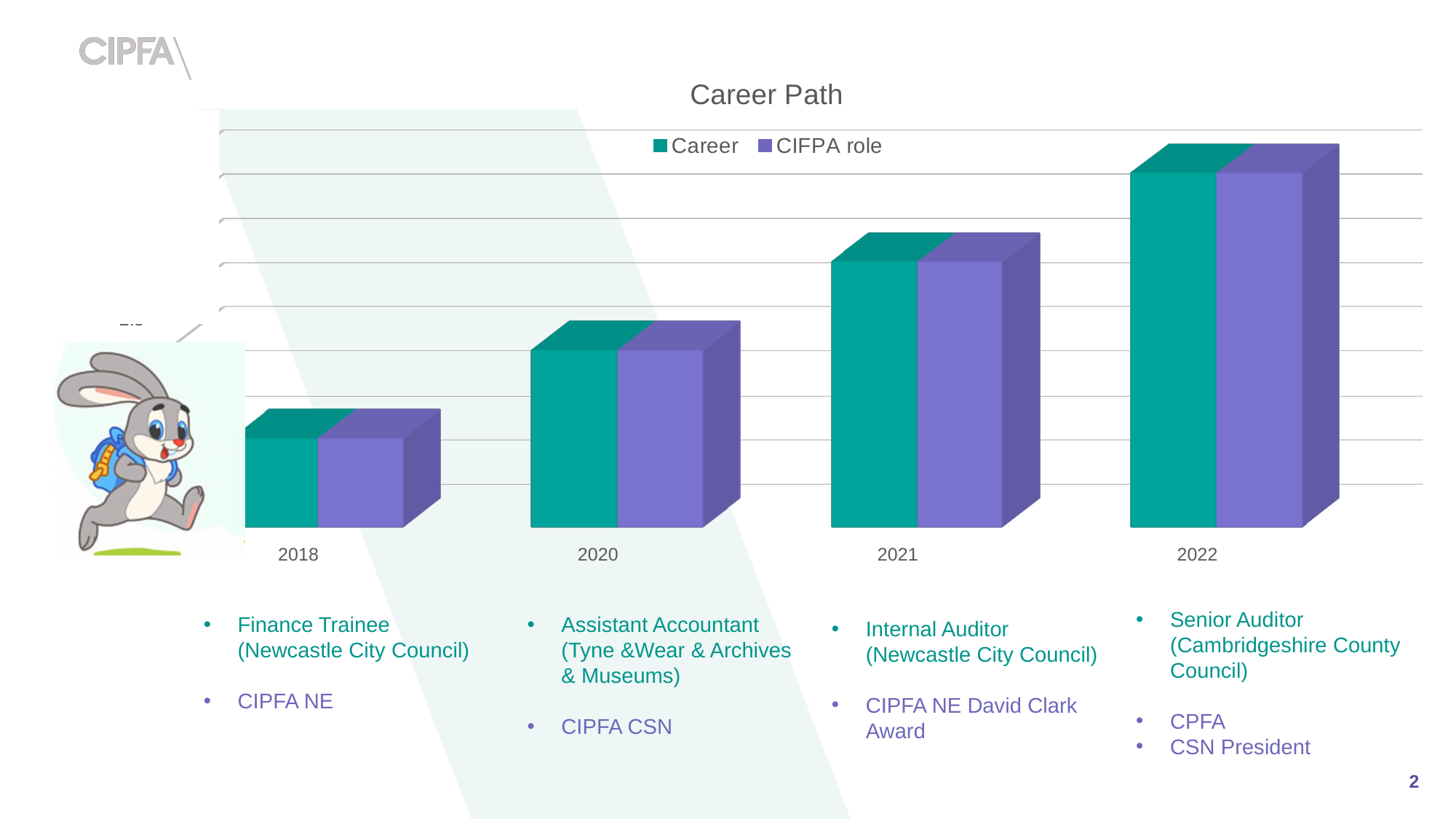
Which year comes first on the x axis? 2018 What are the two series named in the legend? Career and CIFPA role How many categories are shown on the x axis? 4 What is the title of the chart? Career Path Do the bar values rise or fall from 2018 to 2022? rise How many series does the legend list? 2 Which year has the lowest bars? 2018 Which is larger, the Career bar for 2020 or the Career bar for 2021? 2021 Which is larger, the CIFPA role bar for 2018 or the CIFPA role bar for 2022? 2022 Which year has the highest bars? 2022 What kind of chart is shown on the slide? bar chart Which year comes immediately after 2020 on the x axis? 2021